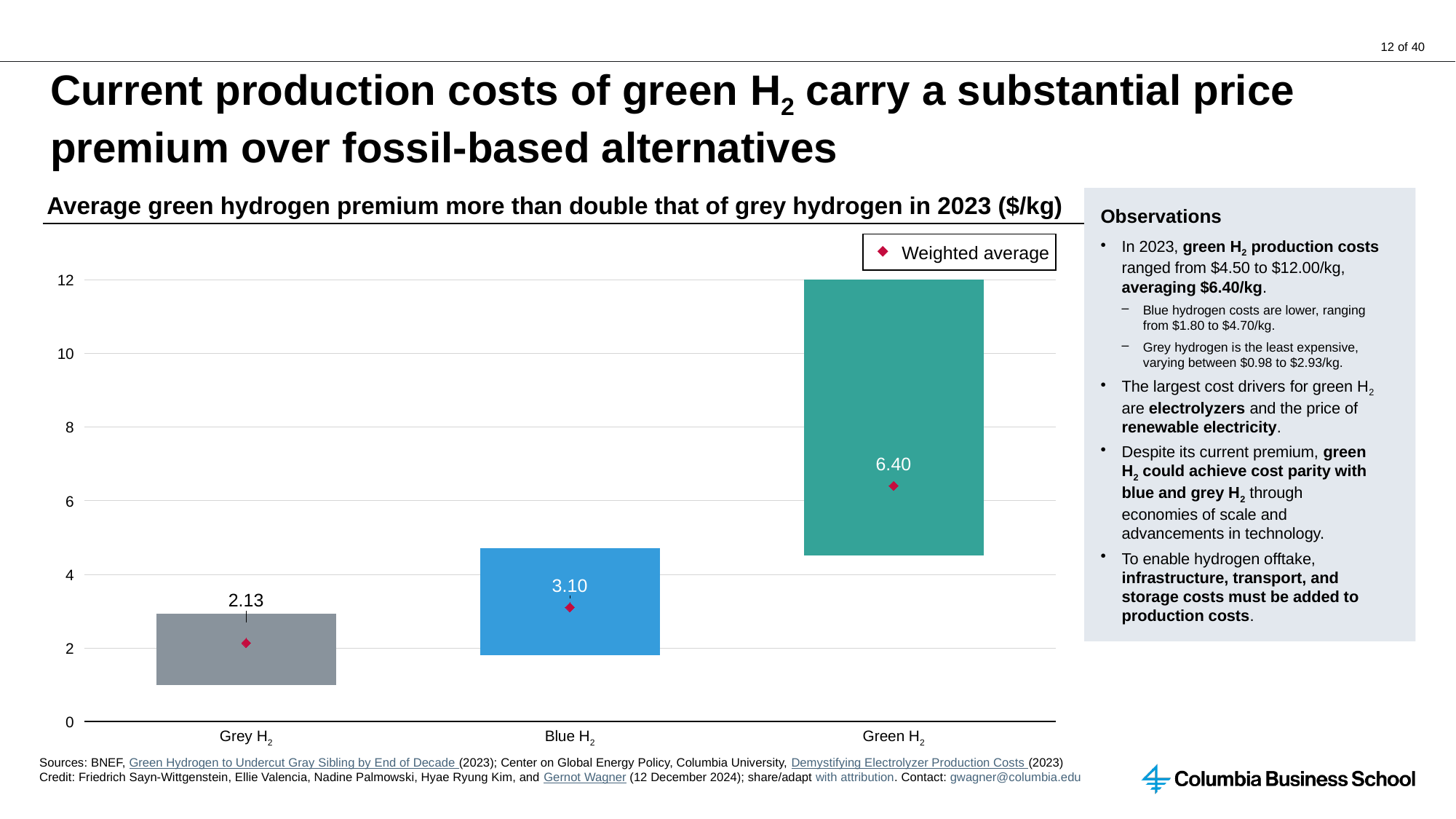
What is the weighted average production cost shown for Grey H2? 2.13 Which hydrogen type has the lowest weighted average cost? Grey H2 Do the weighted average costs rise or fall from Grey H2 to Green H2 along the x axis? rise What is the weighted average production cost shown for Green H2? 6.40 What is the weighted average production cost shown for Blue H2? 3.10 How many hydrogen types are shown on the x axis? 3 Which has a larger weighted average cost, Blue H2 or Grey H2? Blue H2 What is the difference between the weighted average costs of Green H2 and Blue H2? 3.30 What is the difference between the weighted average costs of Green H2 and Grey H2? 4.27 Is the top of the Green H2 cost range greater or less than 10? greater How many entries does the legend list? 1 Which hydrogen type has the highest weighted average cost? Green H2